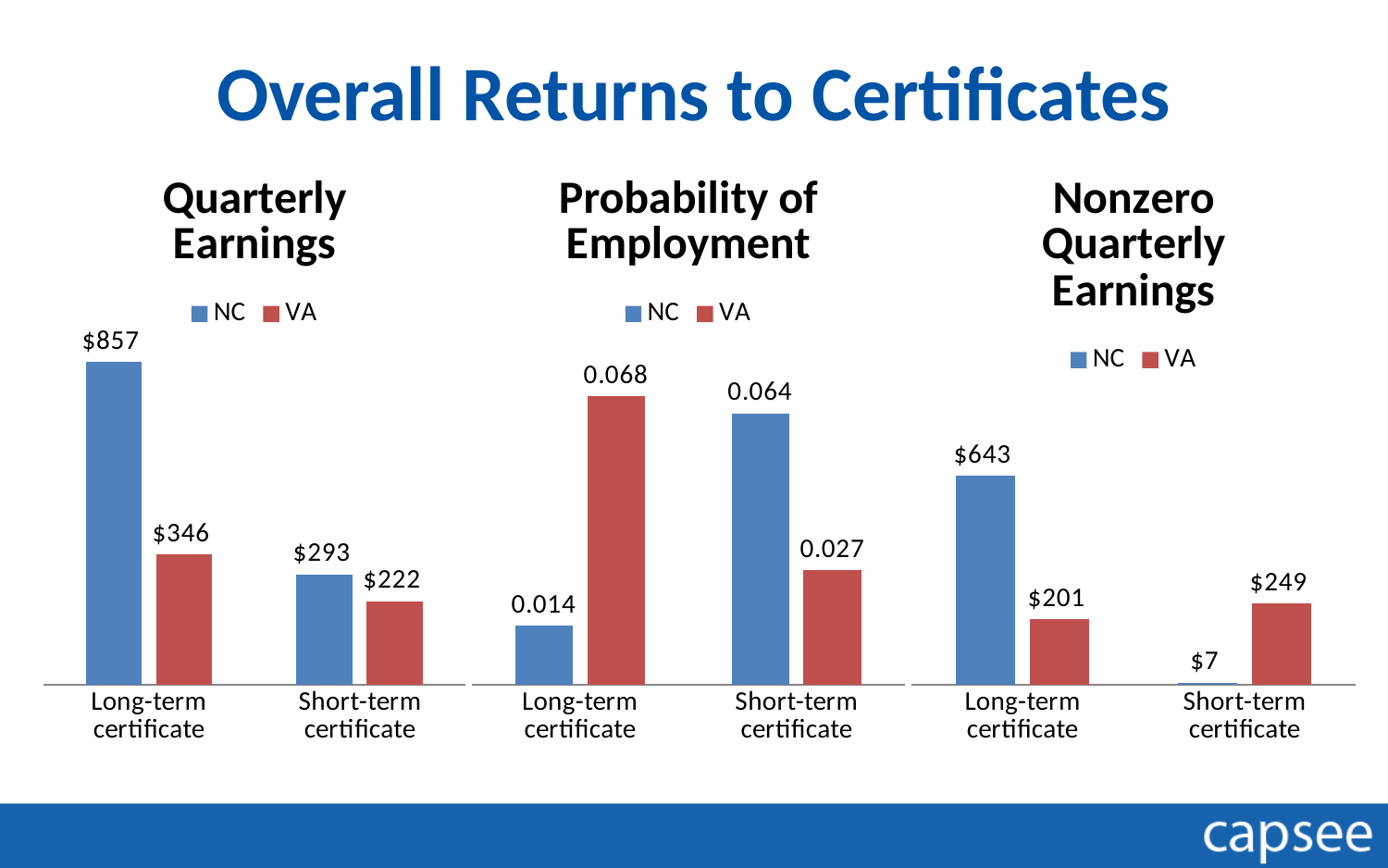
In the Nonzero Quarterly Earnings chart, what is the difference between VA for Short-term certificate and VA for Long-term certificate? $48 In the Probability of Employment chart, which series has the higher value for Short-term certificate, NC or VA? NC In the Quarterly Earnings chart, what is the value for VA for Short-term certificate? $222 In the Nonzero Quarterly Earnings chart, which bar is the lowest? NC, Short-term certificate In the Probability of Employment chart, which bar is the highest? VA, Long-term certificate What kind of chart is the Probability of Employment chart? Bar chart How many categories are shown on the x axis of the Nonzero Quarterly Earnings chart? 2 How many series does the legend of the Quarterly Earnings chart list? 2 In the Probability of Employment chart, what is the value for VA for Long-term certificate? 0.068 In the Quarterly Earnings chart, what is the difference between NC and VA for Long-term certificate? $511 In the Quarterly Earnings chart, what is the value for NC for Long-term certificate? $857 In the Nonzero Quarterly Earnings chart, what is the value for NC for Short-term certificate? $7